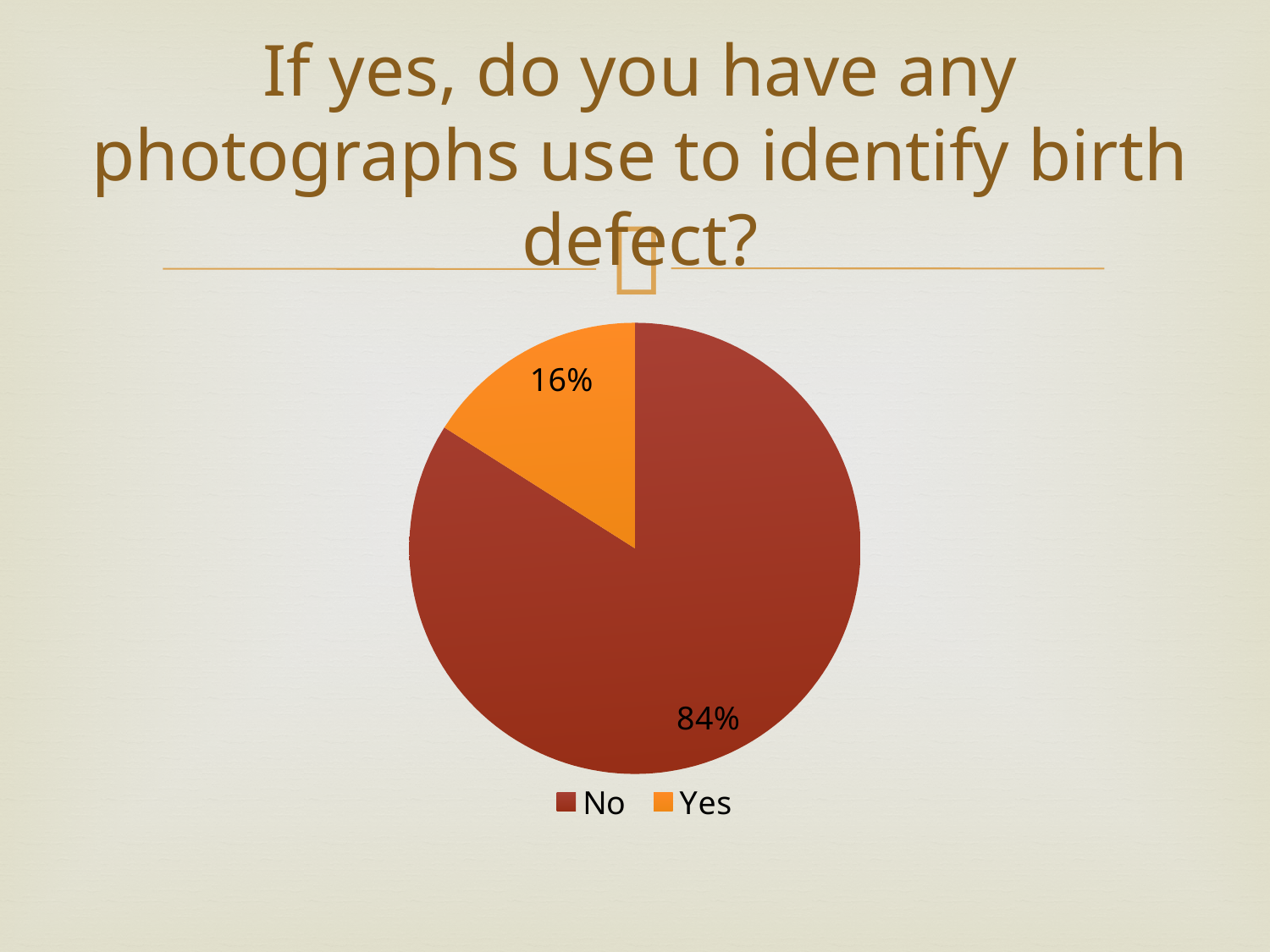
Which is larger, the "No" slice or the "Yes" slice? No What colour is the "Yes" slice? orange What share of the pie does the "Yes" slice represent? 16% Which category has the largest slice of the pie? No How many categories does the pie chart show? 2 What share of the pie does the "No" slice represent? 84% What colour is the "No" slice? dark red What is the difference in percentage points between the "No" and "Yes" slices? 68 How many entries does the legend list? 2 Which category has the smallest slice of the pie? Yes What kind of chart is shown on the slide? pie chart